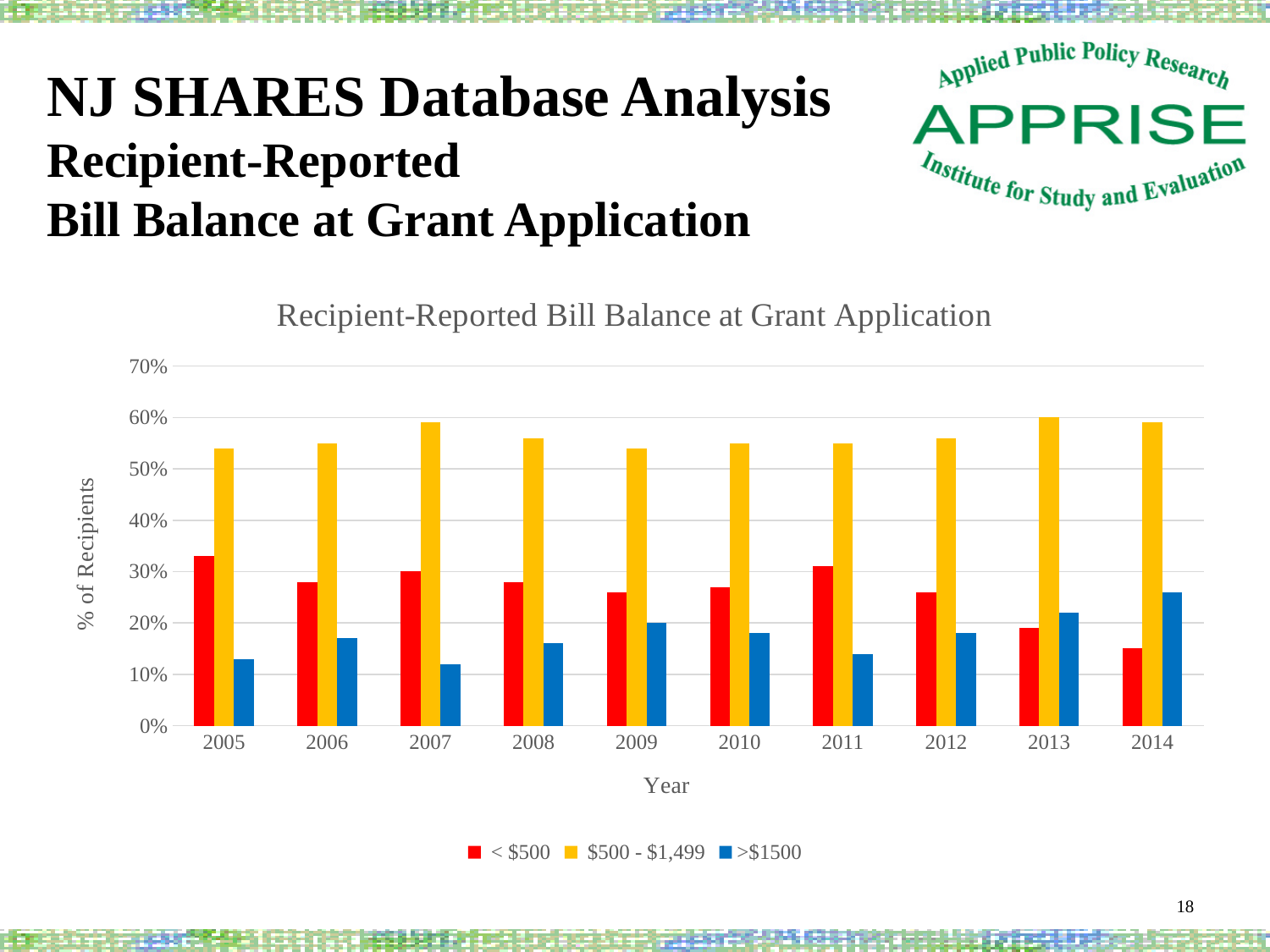
Which colour represents the >$1500 series? Blue Is the value for < $500 in 2014 greater or less than 20%? less Is the value for < $500 in 2005 greater or less than 30%? greater Is the value for >$1500 in 2007 greater or less than 20%? less What is the title of the chart? Recipient-Reported Bill Balance at Grant Application Which is larger in 2010: the < $500 share or the $500 - $1,499 share? $500 - $1,499 How many years are shown on the x axis? 10 In which year is the < $500 share lowest? 2014 In which year is the >$1500 share highest? 2014 What kind of chart is shown on the slide? Bar chart How many series does the legend list? 3